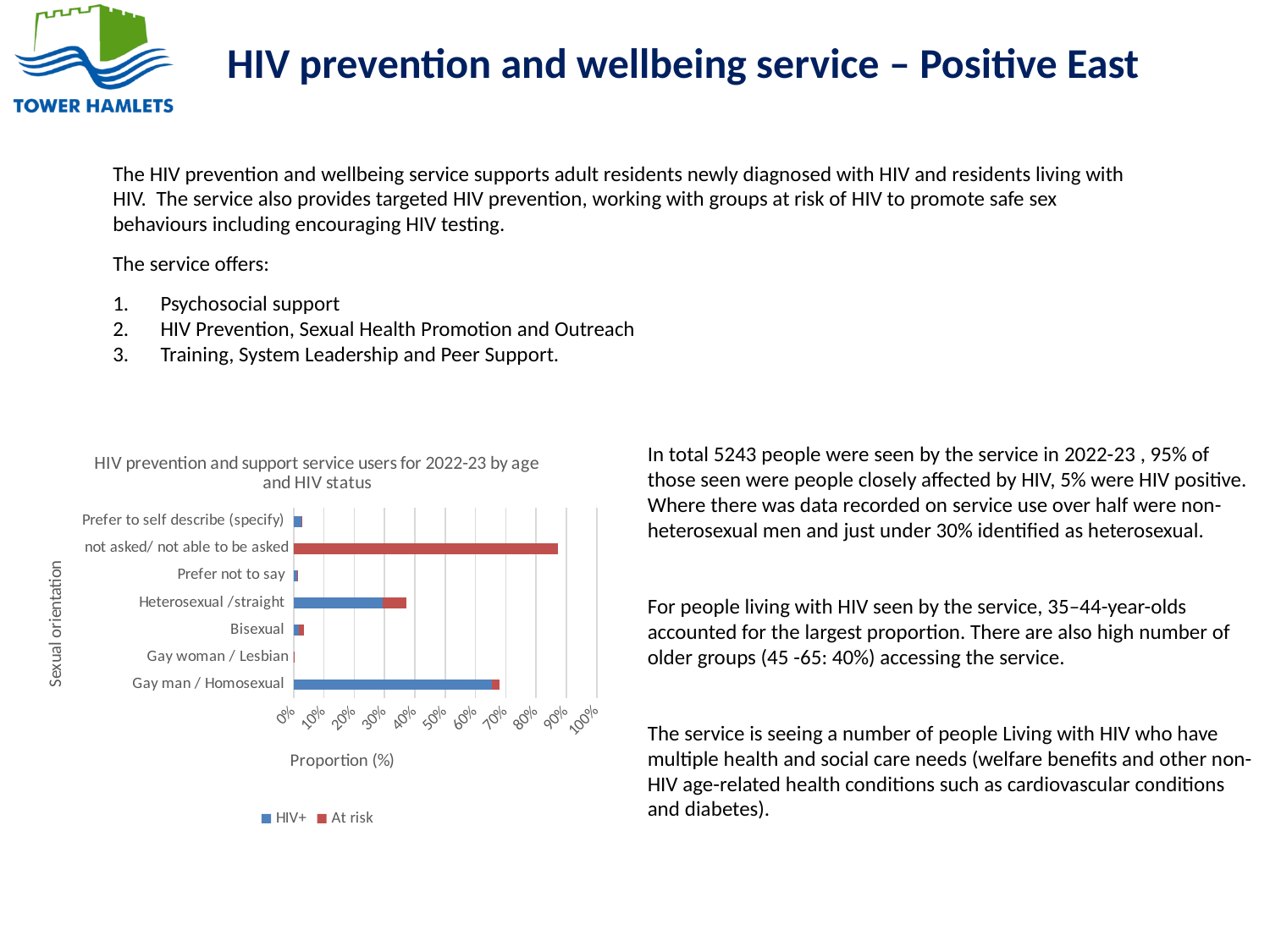
Which category has the largest HIV+ value? Gay man / Homosexual Is the HIV+ value for 'Bisexual' greater or less than 10%? less What kind of chart is shown on the slide? bar chart How many sexual orientation categories are shown on the y axis? 7 What is the title of the x axis? Proportion (%) Is the At risk value for 'not asked/ not able to be asked' greater or less than 80%? greater Is the HIV+ value for 'Gay man / Homosexual' greater or less than 60%? greater Which is larger, the HIV+ value for 'Gay man / Homosexual' or the HIV+ value for 'Heterosexual /straight'? Gay man / Homosexual How many series does the legend list? 2 Which colour represents the 'At risk' series in the legend? red Which category has the largest At risk value? not asked/ not able to be asked